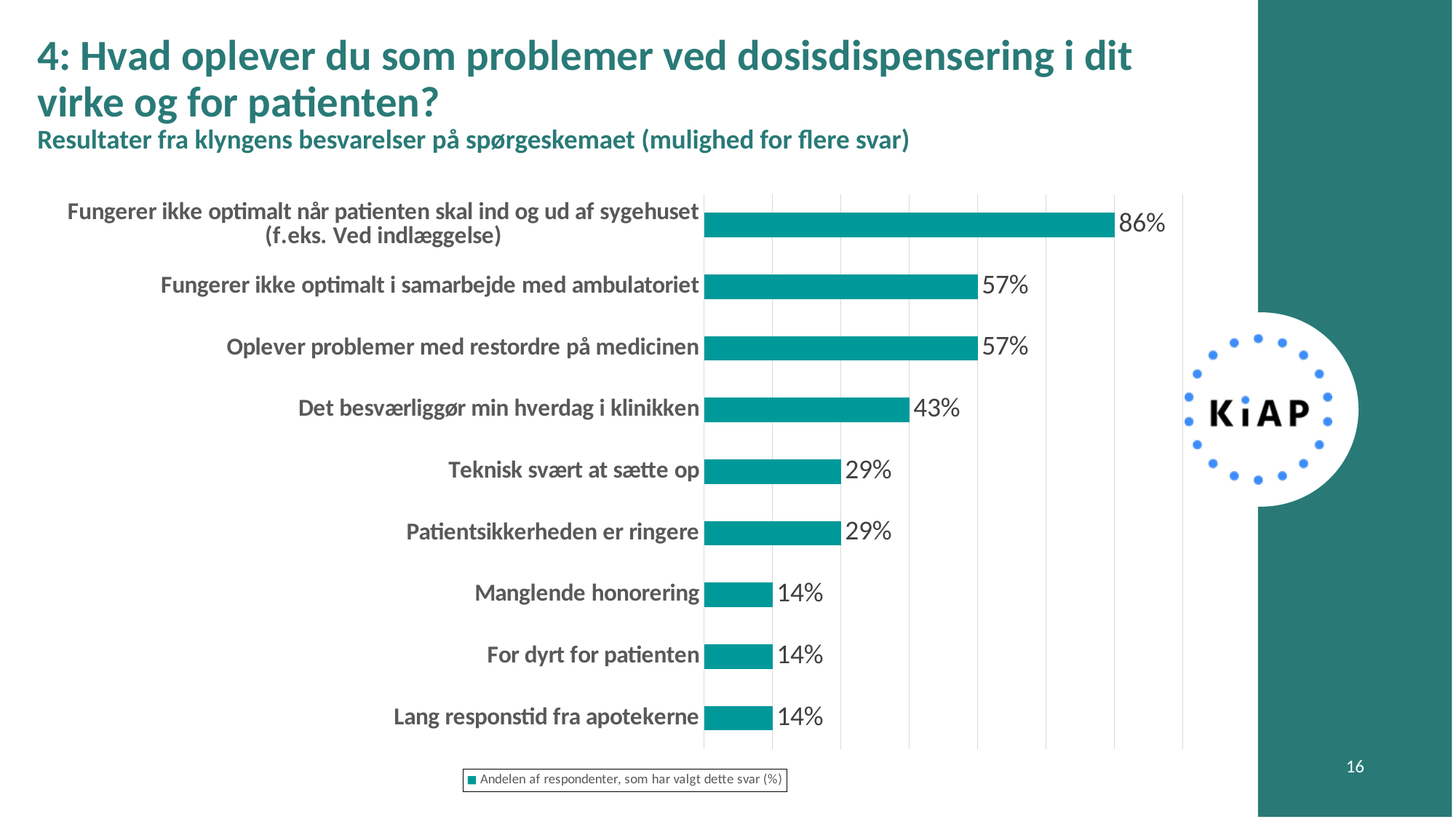
What is the difference between the value for "Fungerer ikke optimalt når patienten skal ind og ud af sygehuset (f.eks. Ved indlæggelse)" and the value for "Fungerer ikke optimalt i samarbejde med ambulatoriet"? 29% Which category has the highest value? Fungerer ikke optimalt når patienten skal ind og ud af sygehuset (f.eks. Ved indlæggelse) What is the legend entry for the series shown in the chart? Andelen af respondenter, som har valgt dette svar (%) What kind of chart is shown on the slide? Bar chart What is the value for "Det besværliggør min hverdag i klinikken"? 43% Which is larger: the value for "Oplever problemer med restordre på medicinen" or the value for "Det besværliggør min hverdag i klinikken"? Oplever problemer med restordre på medicinen How many series does the legend list? 1 What is the difference between the value for "Det besværliggør min hverdag i klinikken" and the value for "Patientsikkerheden er ringere"? 14% What is the value for "Teknisk svært at sætte op"? 29% How many categories are shown in the chart? 9 What is the value for "Manglende honorering"? 14% How many categories have a value of 14%? 3